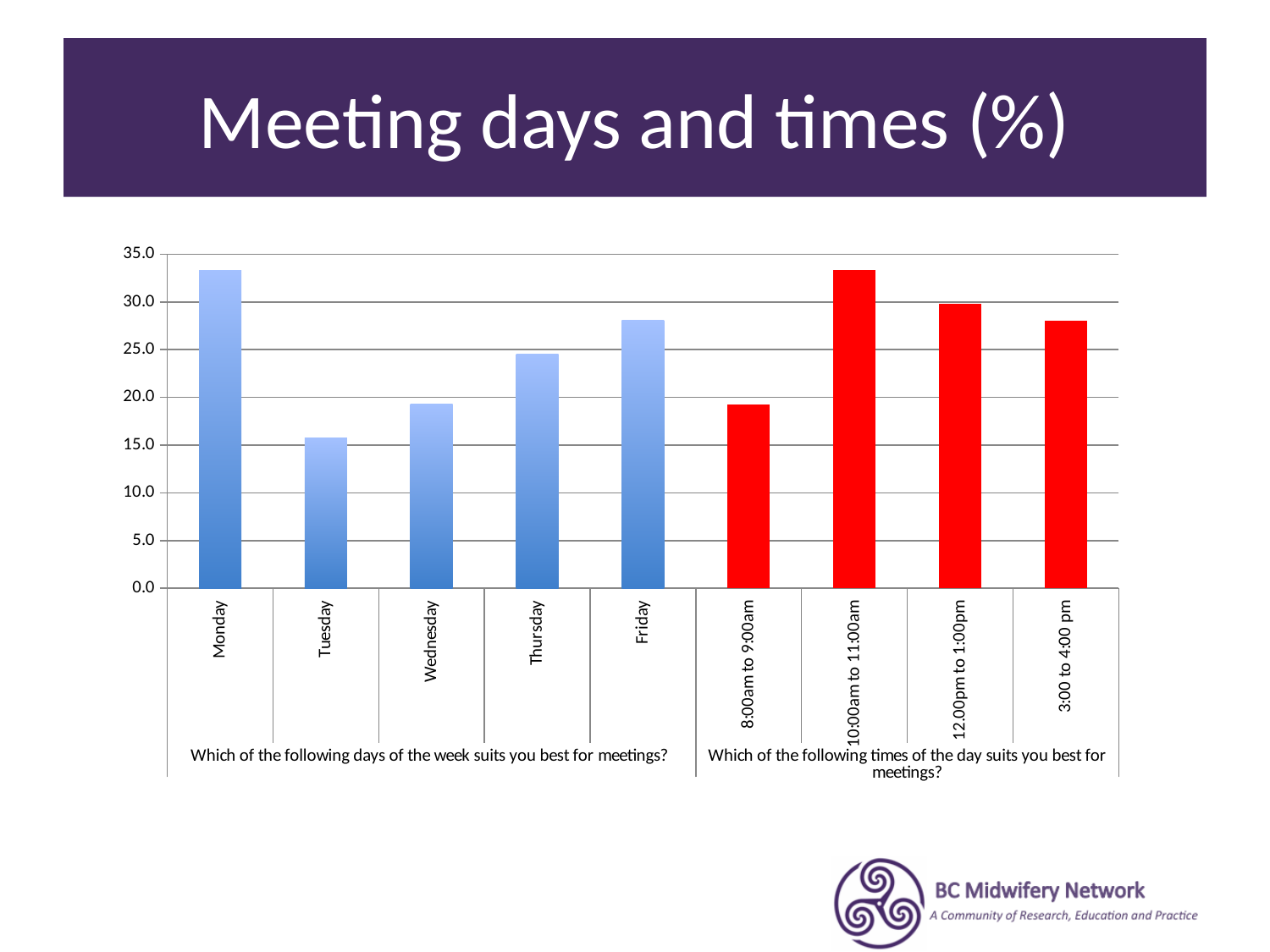
Which time of day has the lowest bar? 8:00am to 9:00am How many bars are plotted in the chart? 9 Is the value for 3:00 to 4:00 pm greater or less than 25? greater Which time of day has the highest bar? 10:00am to 11:00am Do the values rise or fall from Tuesday through Friday? rise Is the value for Monday greater or less than 30? greater Which is larger, the value for Thursday or the value for Friday? Friday What is the title of the slide's chart? Meeting days and times (%) Is the value for Tuesday greater or less than 20? less What kind of chart is shown on the slide? bar chart Which day of the week has the lowest bar? Tuesday Which day of the week has the highest bar? Monday